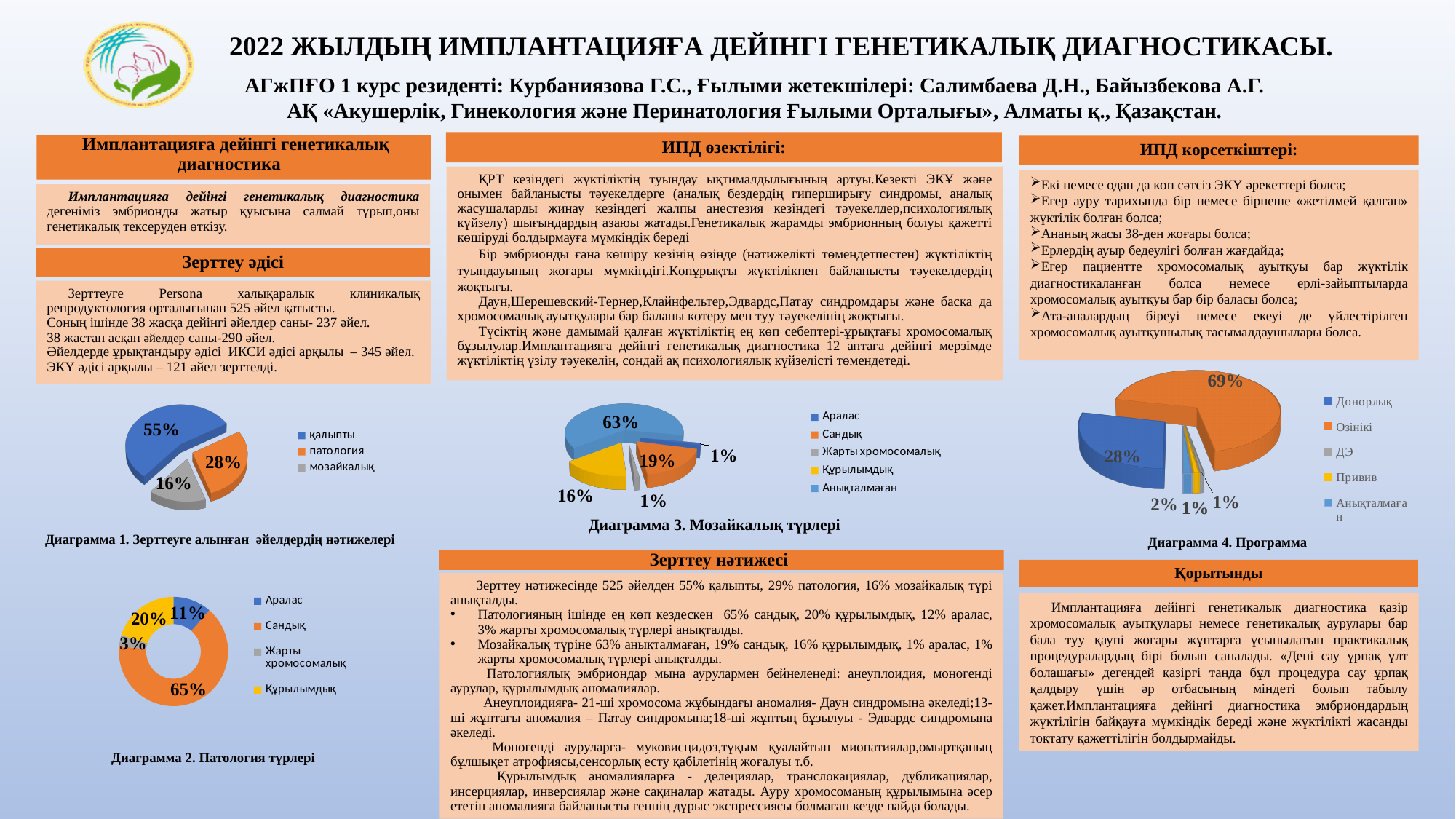
In Диаграмма 2, how many categories does the legend list? 4 In Диаграмма 1, what percentage is shown for қалыпты? 55% In Диаграмма 3, which is larger: Сандық or Құрылымдық? Сандық What type of chart is Диаграмма 2? Doughnut chart In Диаграмма 1, which category has the smallest share? мозайкалық In Диаграмма 2, which category has the smallest share? Жарты хромосомалық In Диаграмма 3, how many categories does the legend list? 5 In Диаграмма 4, what percentage is shown for Өзінікі? 69% In Диаграмма 4, what is the difference between the Өзінікі and Донорлық shares? 41% In Диаграмма 2, what percentage is shown for Сандық? 65% In Диаграмма 3, what percentage is shown for Анықталмаған? 63% In Диаграмма 1, what is the difference between the патология and мозайкалық shares? 12%